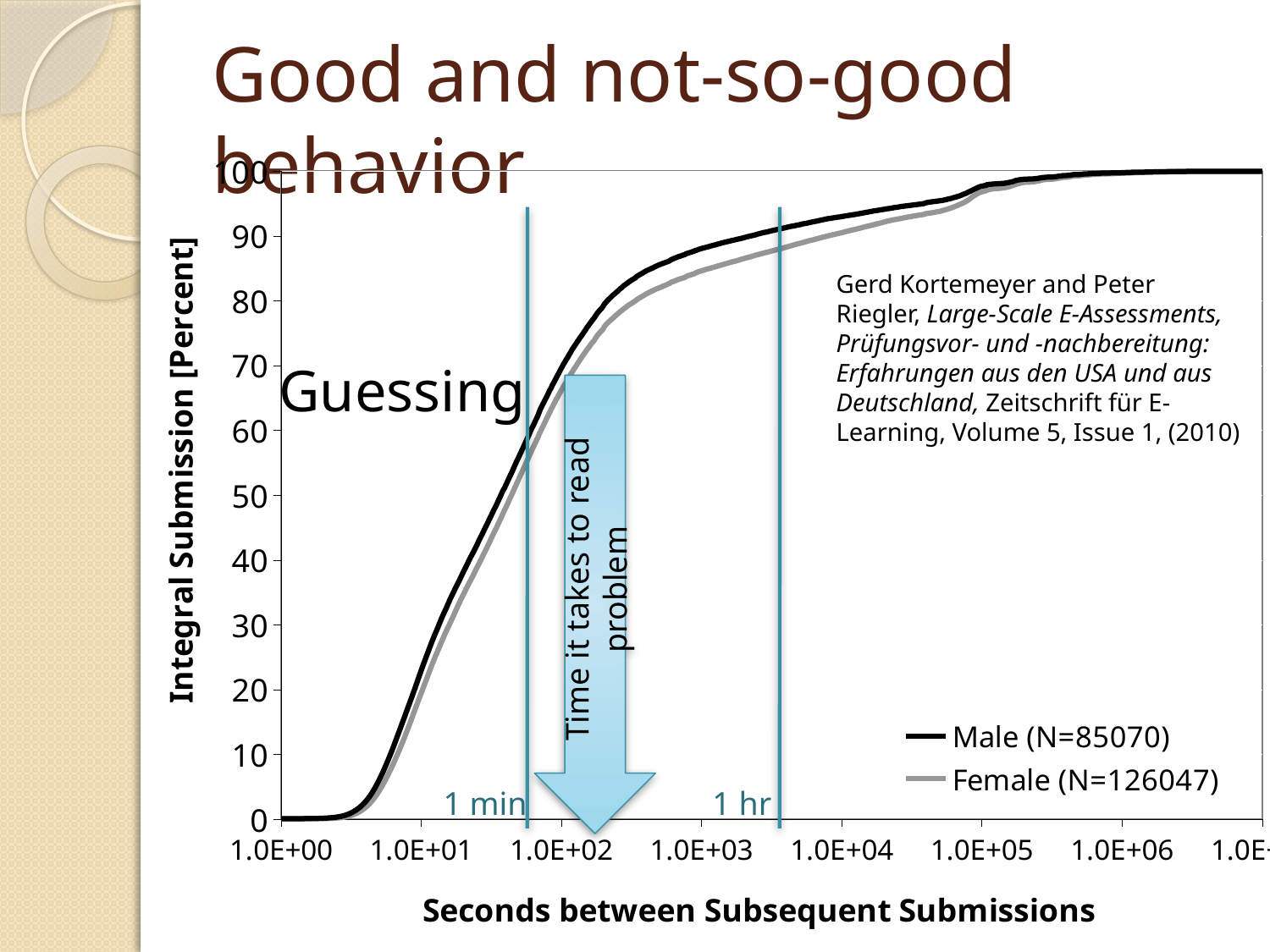
Is the Female value at 1.0E+02 seconds greater or less than 50? greater What is the N value given for the Male series in the legend? 85070 Is the Male value at 1.0E+04 seconds greater or less than 90? greater At 1.0E+02 seconds, which series has the higher integral submission percentage, Male or Female? Male Is the Male value at 1.0E+01 seconds greater or less than 20? greater Which series has the larger N according to the legend? Female (N=126047) What is the N value given for the Female series in the legend? 126047 What is the title of the x axis? Seconds between Subsequent Submissions Do the curves rise or fall as the seconds between subsequent submissions increase? Rise What is the title of the y axis? Integral Submission [Percent] How many series does the legend list? 2 What kind of chart is shown on the slide? Line chart